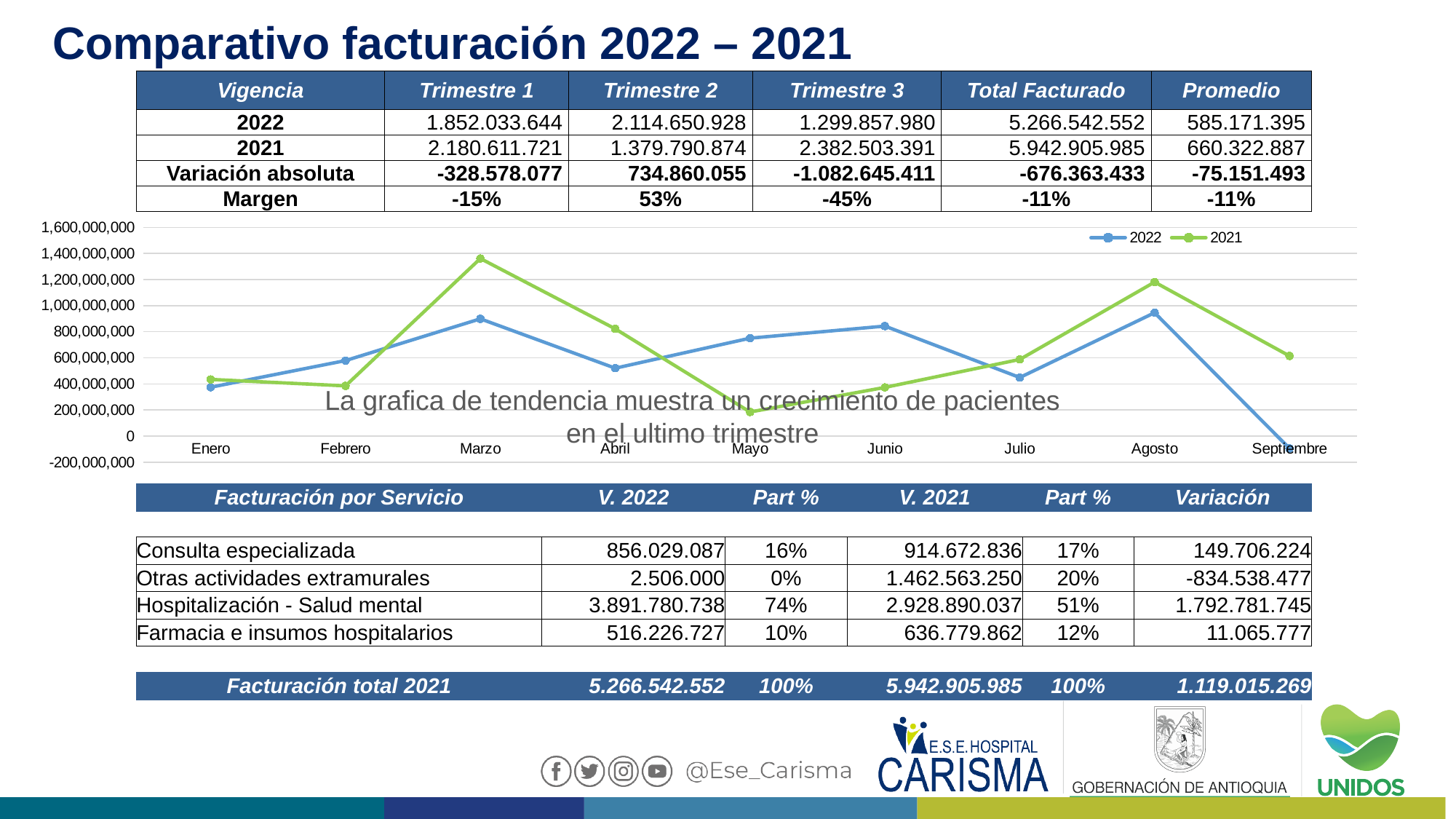
Which colour is used for the 2021 series in the chart? green In which month does the 2022 series reach its lowest value? Septiembre What kind of chart is shown on the slide? line chart How many months are plotted along the x axis of the chart? 9 In which month does the 2021 series reach its highest value? Marzo Is the 2021 value for Marzo greater or less than 1,200,000,000? greater Is the 2021 value for Mayo greater or less than 400,000,000? less Does the 2021 series rise or fall from Marzo to Mayo? fall How many series does the chart legend list? 2 Is the 2022 value for Septiembre greater or less than 0? less In which month does the 2021 series reach its lowest value? Mayo In Febrero, which series has the larger value, 2022 or 2021? 2022